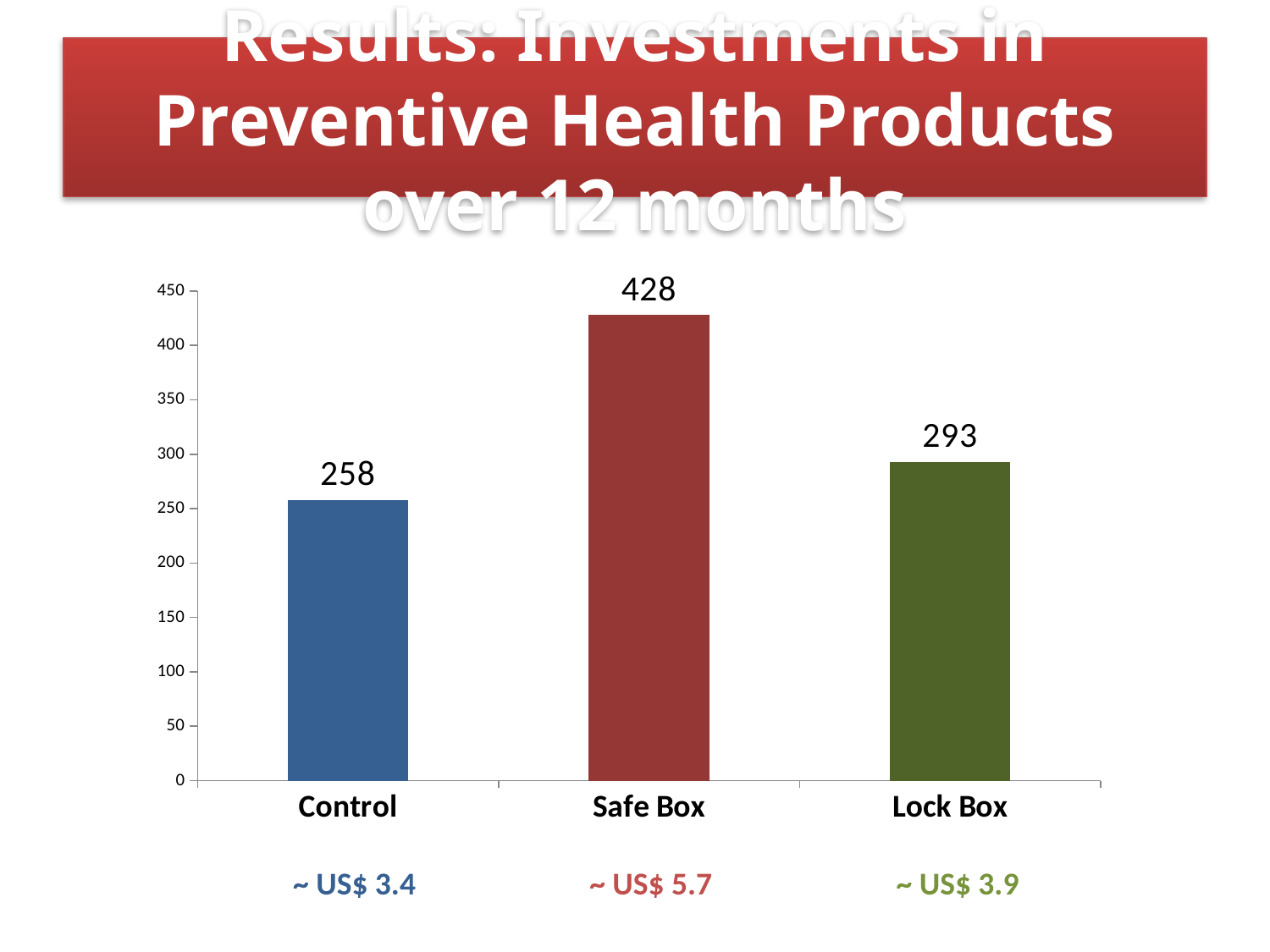
Which category has the highest value? Safe Box Which is larger, the value for Lock Box or the value for Control? Lock Box What is the value for Control? 258 What kind of chart is shown on the slide? bar chart How many categories are shown on the x axis? 3 What approximate US dollar amount is shown below the Safe Box bar? ~ US$ 5.7 What is the difference between the values for Lock Box and Control? 35 Is the value for Safe Box greater or less than 400? greater What is the difference between the values for Safe Box and Control? 170 Which category has the lowest value? Control What is the value for Safe Box? 428 What is the value for Lock Box? 293